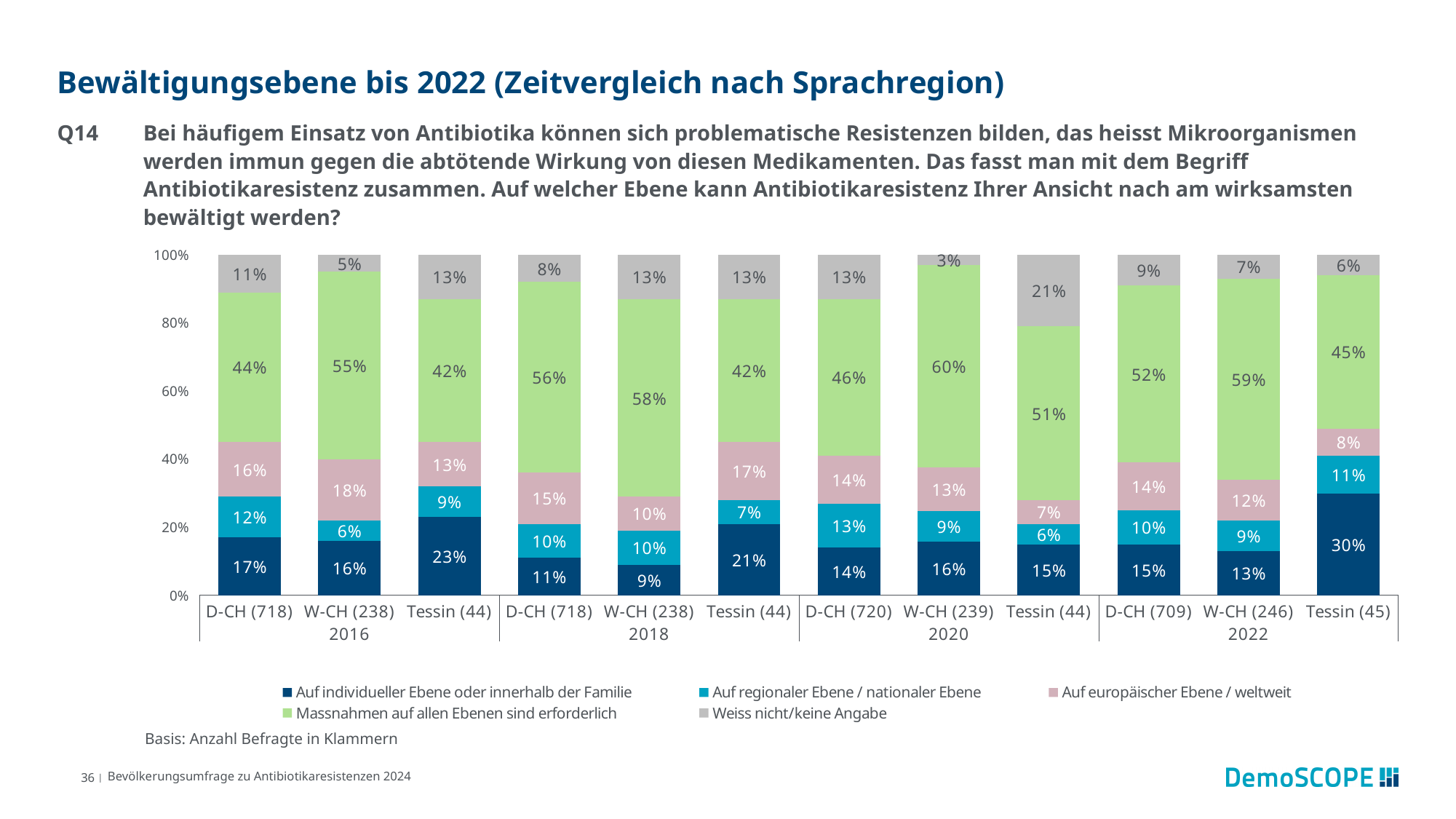
How many series does the legend list? 5 What is the value for 'Massnahmen auf allen Ebenen sind erforderlich' for W-CH (239) in 2020? 60% What is the difference between the 'Massnahmen auf allen Ebenen sind erforderlich' values for W-CH (238) and D-CH (718) in 2016? 11% Which colour represents 'Massnahmen auf allen Ebenen sind erforderlich' in the chart? Light green What is the value for 'Auf individueller Ebene oder innerhalb der Familie' for Tessin (45) in 2022? 30% Which is larger: the 'Auf europäischer Ebene / weltweit' value for W-CH (238) in 2016 or for W-CH (238) in 2018? W-CH (238) in 2016 How does the 'Auf individueller Ebene oder innerhalb der Familie' value for Tessin change from 2020 to 2022? It rises from 15% to 30% Which bar has the highest value for 'Auf individueller Ebene oder innerhalb der Familie'? Tessin (45) 2022 What is the value for 'Weiss nicht/keine Angabe' for Tessin (44) in 2020? 21% Which bar has the lowest value for 'Weiss nicht/keine Angabe'? W-CH (239) 2020 What kind of chart is shown on the slide? Stacked bar chart How many bars are plotted in the chart? 12